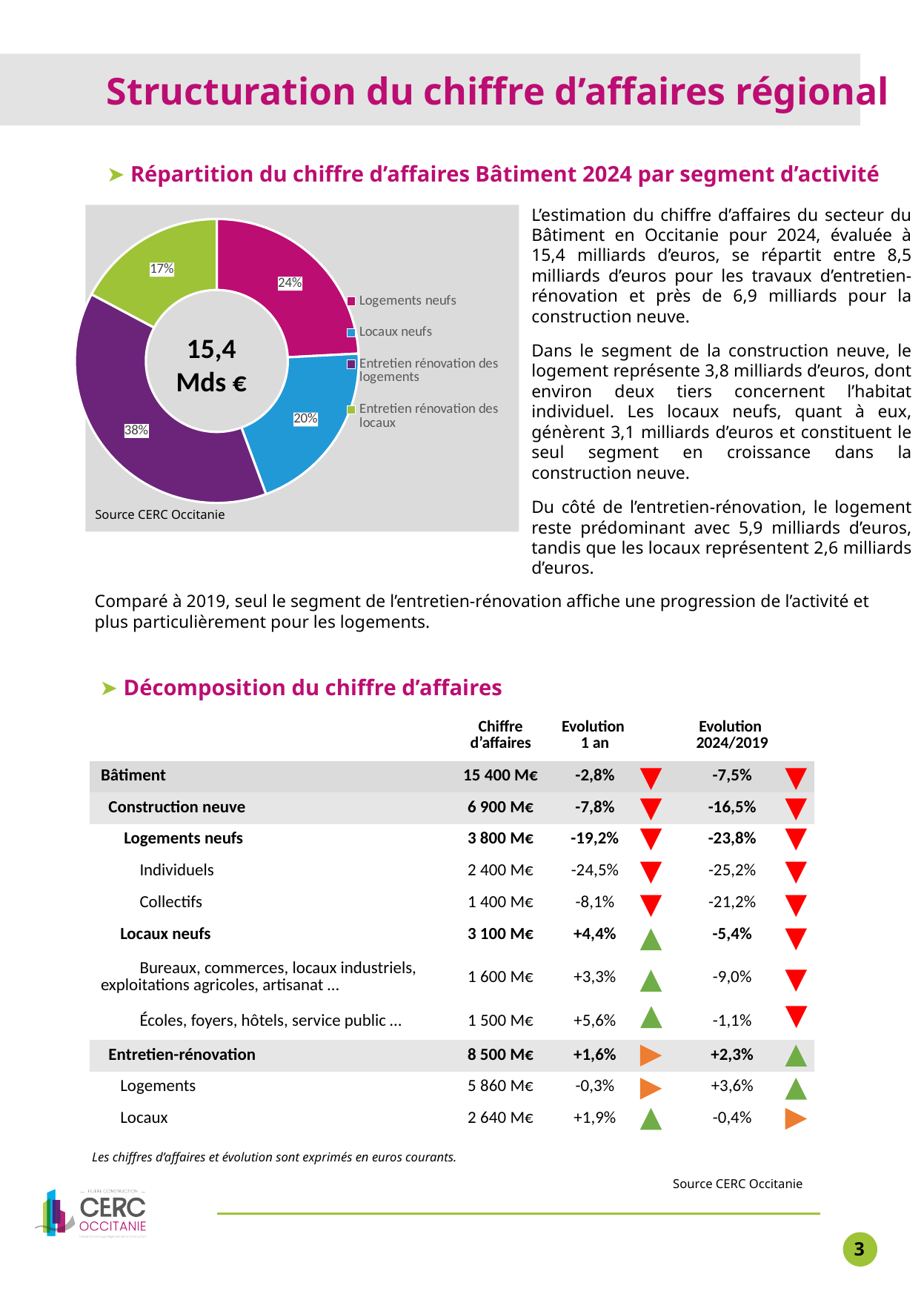
What share of the chart does "Entretien rénovation des locaux" represent? 17% Which segment has the largest share in the chart? Entretien rénovation des logements What share of the chart does "Logements neufs" represent? 24% What total value is displayed in the centre of the chart? 15,4 Mds € Which segment has the smallest share in the chart? Entretien rénovation des locaux What is the difference in percentage points between "Entretien rénovation des logements" and "Logements neufs"? 14 percentage points Which is larger: the share for "Logements neufs" or the share for "Locaux neufs"? Logements neufs What kind of chart is shown on the slide? Doughnut (pie) chart What share of the chart does "Locaux neufs" represent? 20% What colour is the "Entretien rénovation des locaux" segment in the chart? Green How many segments does the chart have? 4 What share of the chart does "Entretien rénovation des logements" represent? 38%